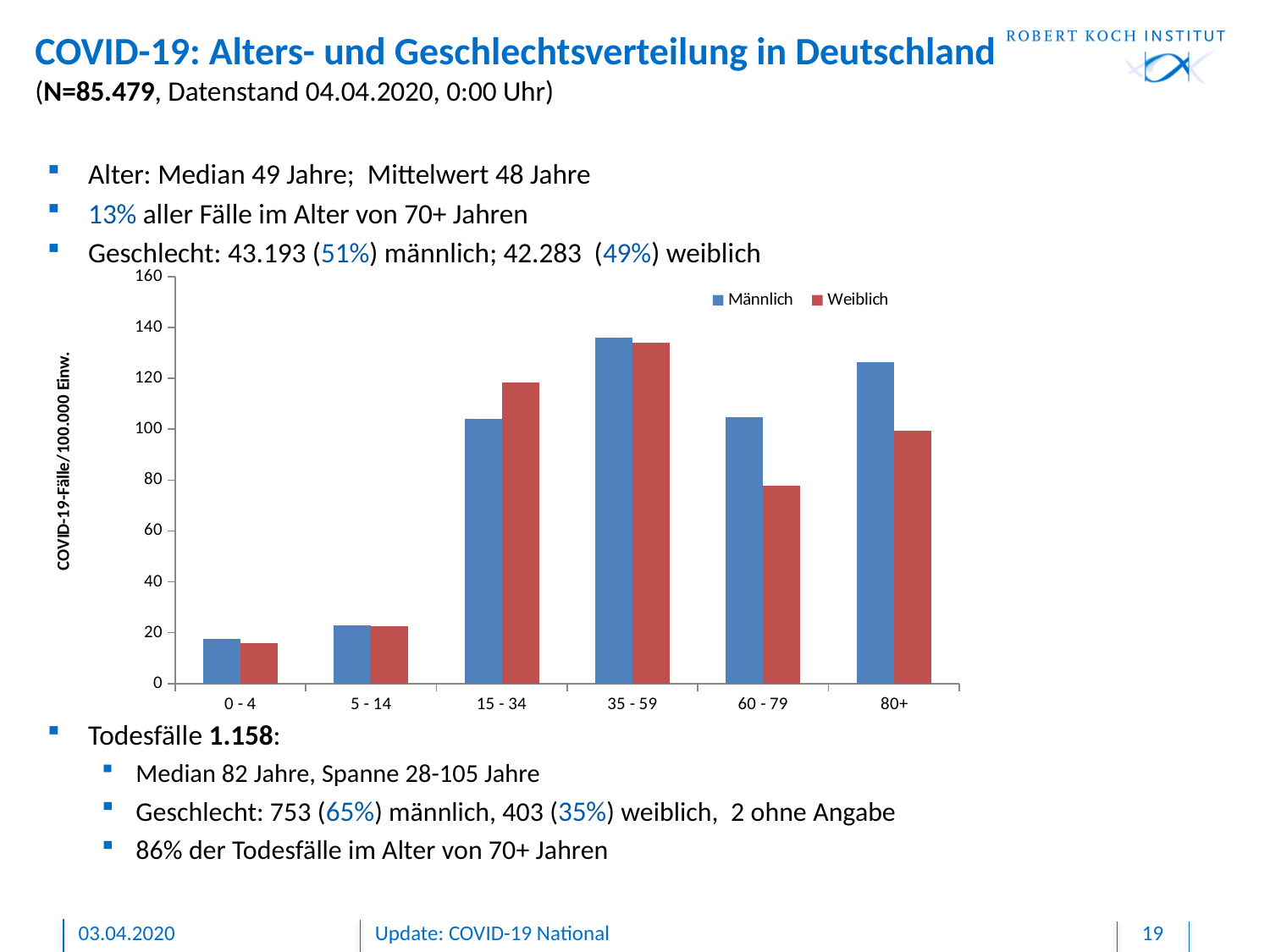
Which age group has the highest value for Weiblich? 35 - 59 Is the value for Männlich in the 35 - 59 age group greater or less than 120? greater Which age group has the lowest value for Männlich? 0 - 4 What is the label of the y axis of the chart? COVID-19-Fälle/100.000 Einw. Is the value for Weiblich in the 60 - 79 age group greater or less than 100? less How many age groups are shown on the x axis of the chart? 6 Is the value for Männlich in the 0 - 4 age group greater or less than 20? less What kind of chart is shown on the slide? bar chart Which age group has the highest value for Männlich? 35 - 59 In the 15 - 34 age group, which series has the larger value, Männlich or Weiblich? Weiblich In the 60 - 79 age group, which series has the larger value, Männlich or Weiblich? Männlich How many series does the chart legend list? 2